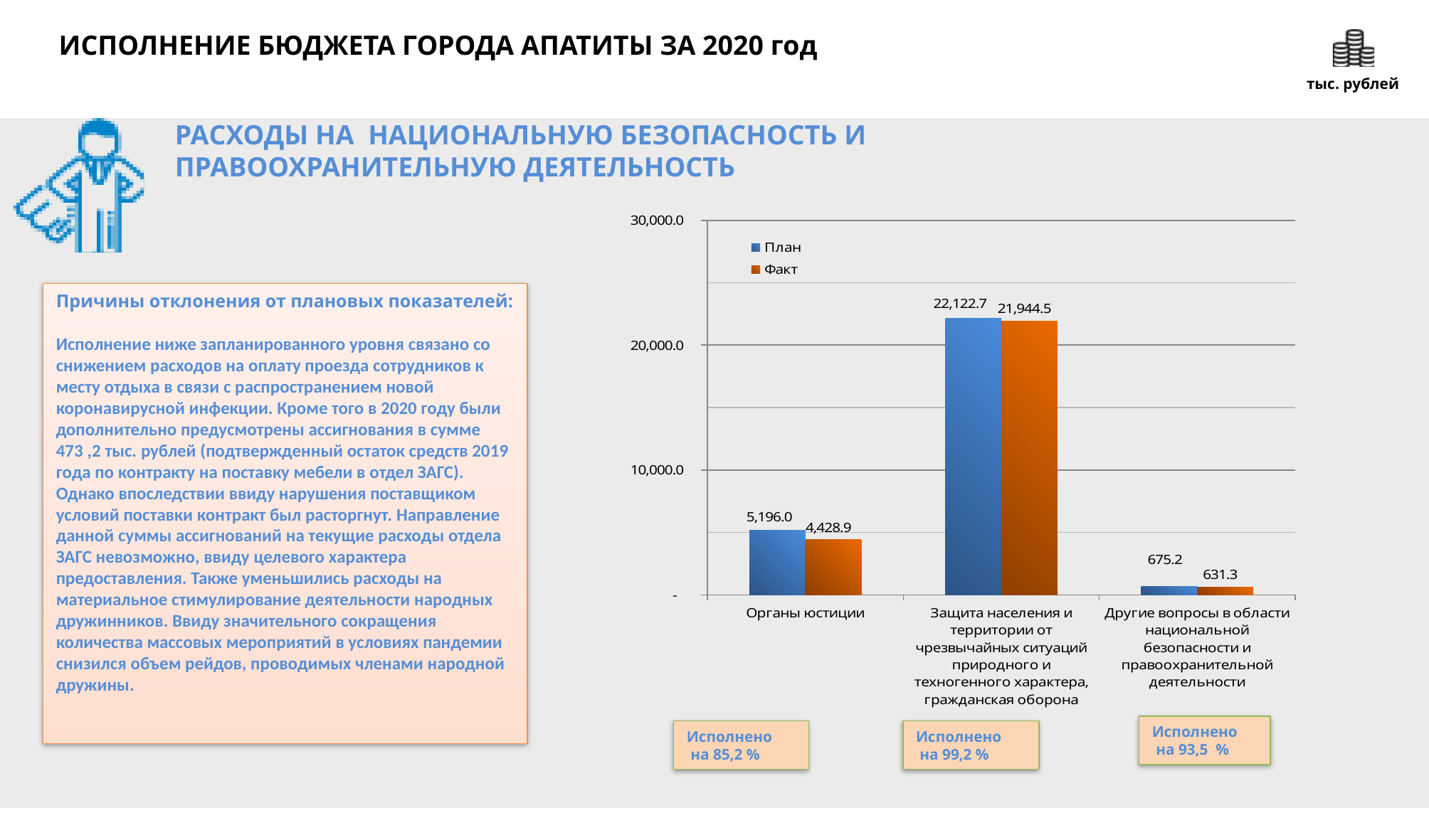
What is the Факт value for Другие вопросы в области национальной безопасности и правоохранительной деятельности? 631.3 How many series does the chart legend list? 2 What kind of chart is shown on the slide? Bar chart What is the difference between the План and Факт values for Другие вопросы в области национальной безопасности и правоохранительной деятельности? 43.9 How many categories are shown on the x axis of the chart? 3 What is the План value for Органы юстиции? 5,196.0 Which is larger for Защита населения и территории от чрезвычайных ситуаций: the План value or the Факт value? План What is the План value for Защита населения и территории от чрезвычайных ситуаций природного и техногенного характера, гражданская оборона? 22,122.7 What is the difference between the План and Факт values for Органы юстиции? 767.1 Which category has the lowest План value? Другие вопросы в области национальной безопасности и правоохранительной деятельности What is the Факт value for Органы юстиции? 4,428.9 Which category has the highest Факт value? Защита населения и территории от чрезвычайных ситуаций природного и техногенного характера, гражданская оборона